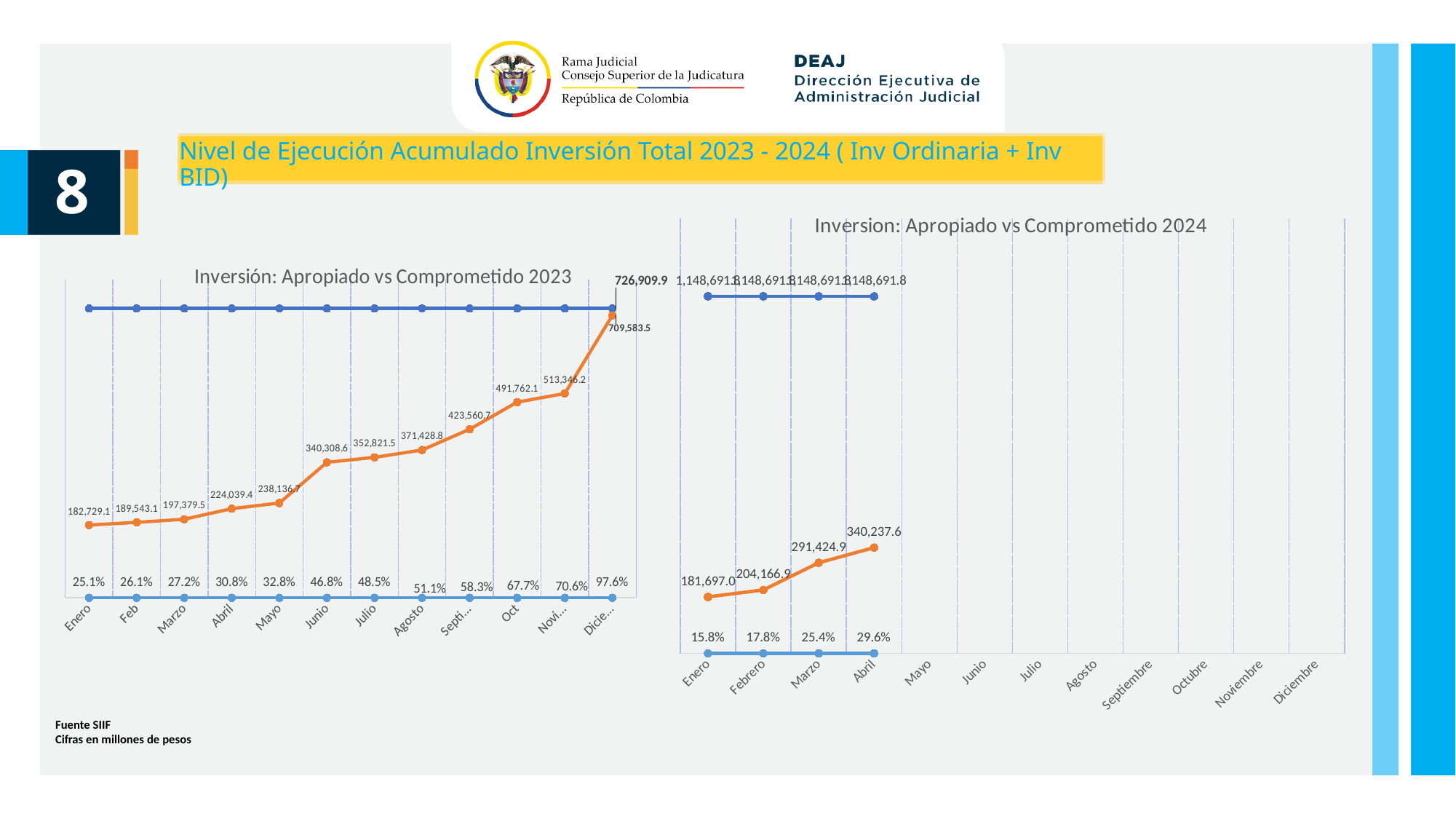
In the 'Inversión: Apropiado vs Comprometido 2023' chart, what is the difference between the orange line values for Oct and Septiembre? 68,201.4 In the 'Inversión: Apropiado vs Comprometido 2023' chart, what value is labelled on the blue line at the December point? 726,909.9 In the 'Inversión: Apropiado vs Comprometido 2023' chart, what is the value of the orange line for Junio? 340,308.6 In the 'Inversión: Apropiado vs Comprometido 2023' chart, what percentage is shown for Oct? 67.7% In the 'Inversion: Apropiado vs Comprometido 2024' chart, what value is shown on the blue line for Enero? 1,148,691.8 In the 'Inversion: Apropiado vs Comprometido 2024' chart, how many months have plotted data points? 4 In the 'Inversion: Apropiado vs Comprometido 2024' chart, what is the difference between the orange line values for Abril and Marzo? 48,812.7 In the 'Inversión: Apropiado vs Comprometido 2023' chart, which month has the highest value on the orange line? Diciembre In the 'Inversión: Apropiado vs Comprometido 2023' chart, what is the value of the orange line for Enero? 182,729.1 In the 'Inversion: Apropiado vs Comprometido 2024' chart, what is the value of the orange line for Marzo? 291,424.9 In the 'Inversión: Apropiado vs Comprometido 2023' chart, does the orange line rise or fall from Enero to Diciembre? rise What kind of chart is 'Inversion: Apropiado vs Comprometido 2024'? line chart